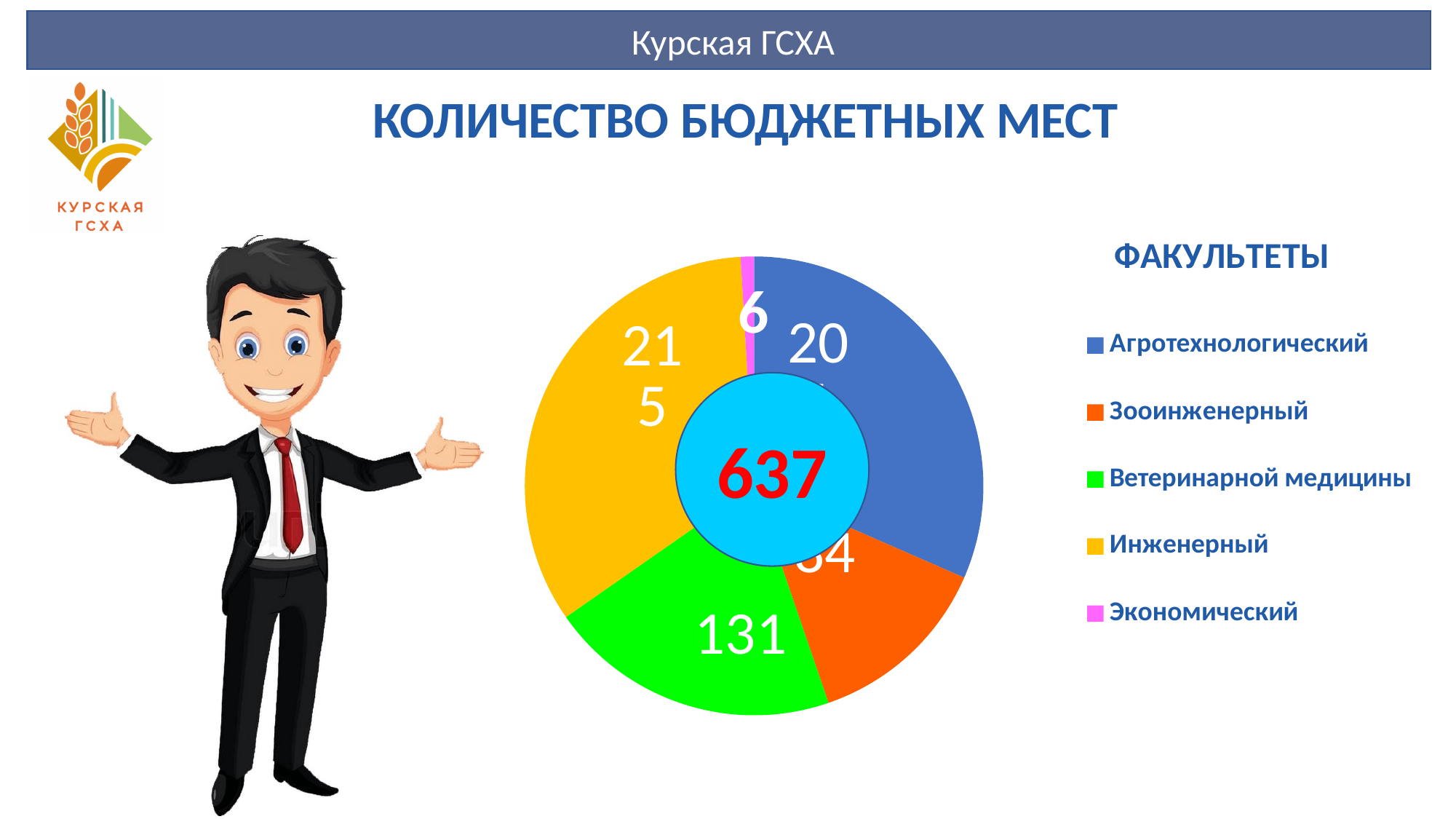
How many faculties are listed in the chart legend? 5 Which slice is larger: Инженерный or Ветеринарной медицины? Инженерный Which slice is larger: Агротехнологический or Зооинженерный? Агротехнологический What value is shown for the Ветеринарной медицины slice of the pie chart? 131 What value is shown for the Инженерный slice of the pie chart? 215 What type of chart is shown on the slide? Pie chart What is the difference between the Инженерный value and the Ветеринарной медицины value? 84 What total number is printed in the centre of the pie chart? 637 How many budget places does the Экономический faculty have in the pie chart? 6 Which faculty has the largest slice in the pie chart? Инженерный What is the heading above the chart legend? ФАКУЛЬТЕТЫ Which faculty has the smallest slice in the pie chart? Экономический